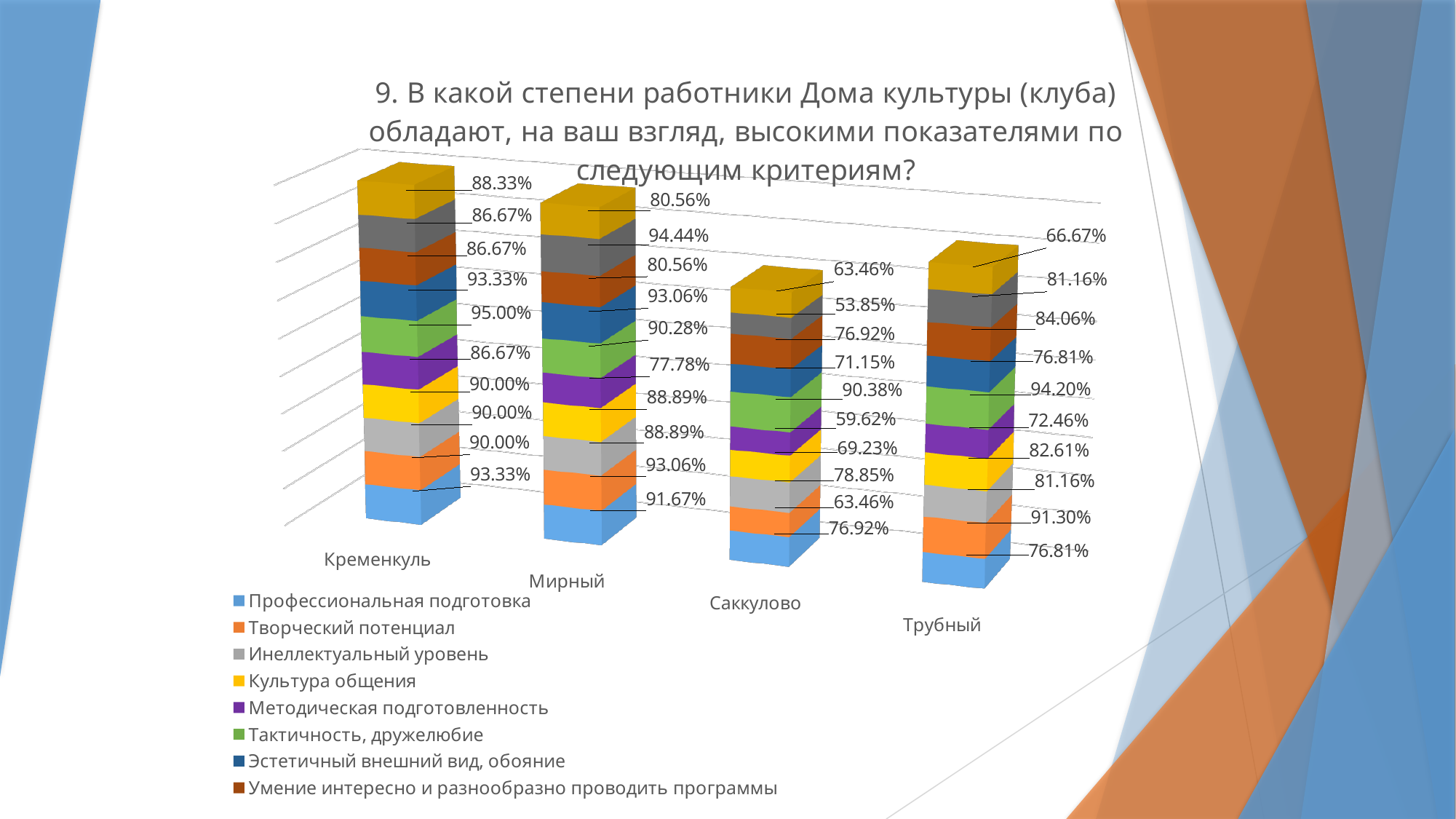
What is the value for Тактичность, дружелюбие in Трубный? 94.20% What is the value for Профессиональная подготовка in Кременкуль? 93.33% Which location has the highest value for Тактичность, дружелюбие? Кременкуль Which series is listed first in the legend? Профессиональная подготовка How many locations (categories) are shown on the x axis? 4 How many series does the legend list? 8 What is the difference between Профессиональная подготовка in Кременкуль (93.33%) and in Саккулово (76.92%)? 16.41 percentage points Which is larger: Профессиональная подготовка in Кременкуль or in Саккулово? Кременкуль What is the value for Методическая подготовленность in Мирный? 77.78% What is the value for Творческий потенциал in Саккулово? 63.46% Which location has the lowest value for Методическая подготовленность? Саккулово What kind of chart is shown on the slide? Stacked bar chart